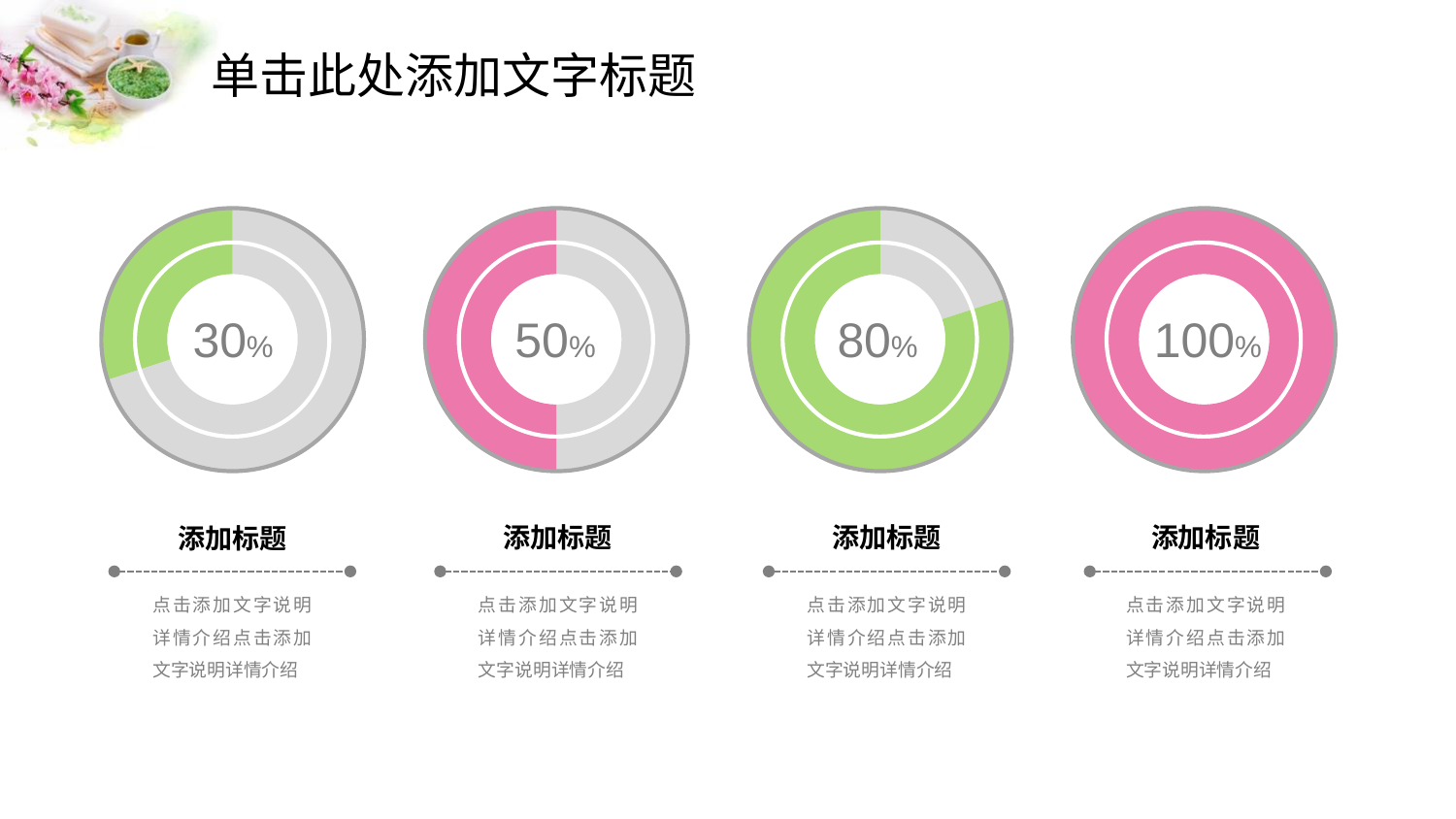
Which is larger, the percentage in the second doughnut chart or the percentage in the third doughnut chart? The third chart (80%) What kind of chart is used to display the percentages on the slide? Doughnut chart What value is shown in the center of the rightmost doughnut chart? 100% How many doughnut charts are on the slide? 4 Do the percentages increase or decrease from the leftmost chart to the rightmost chart? Increase What is the difference between the percentage in the third doughnut chart and the percentage in the leftmost doughnut chart? 50% What colour is the filled portion of the second doughnut chart from the left? Pink Which doughnut chart shows the highest percentage? The rightmost chart (100%) What value is shown in the center of the leftmost doughnut chart? 30% What value is shown in the center of the second doughnut chart from the left? 50% What value is shown in the center of the third doughnut chart from the left? 80% Which doughnut chart shows the lowest percentage? The leftmost chart (30%)